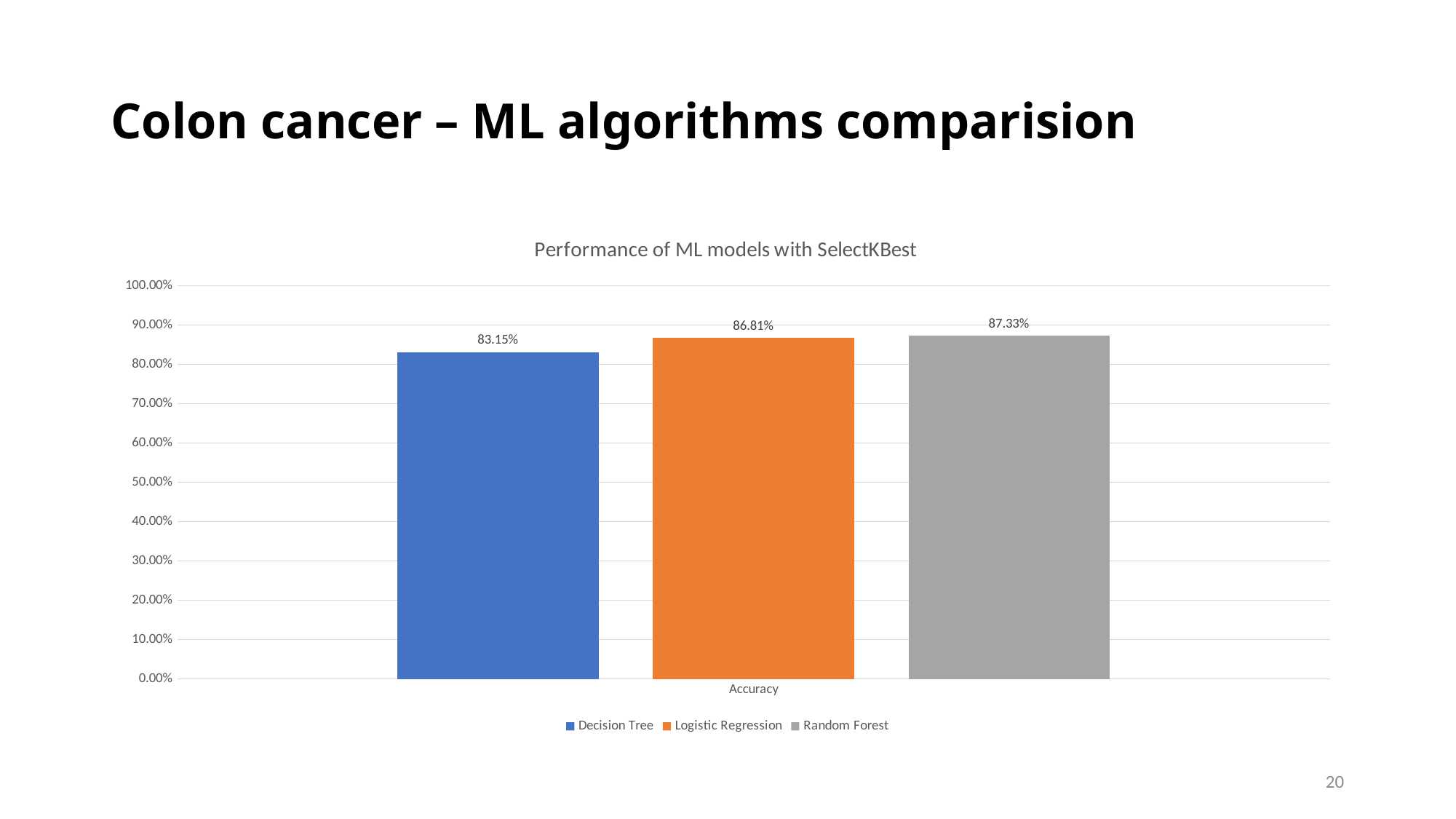
What is the title of the chart? Performance of ML models with SelectKBest Which has a higher accuracy, Decision Tree or Logistic Regression? Logistic Regression What is the accuracy of the Decision Tree model? 83.15% Which model has the highest accuracy? Random Forest What is the accuracy of the Logistic Regression model? 86.81% What is the difference in accuracy between Random Forest and Decision Tree? 4.18% What kind of chart is shown on the slide? Bar chart How many series does the legend list? 3 What is the accuracy of the Random Forest model? 87.33% Which model has the lowest accuracy? Decision Tree Is the accuracy of the Decision Tree model greater or less than 90.00%? less What is the difference in accuracy between Logistic Regression and Decision Tree? 3.66%